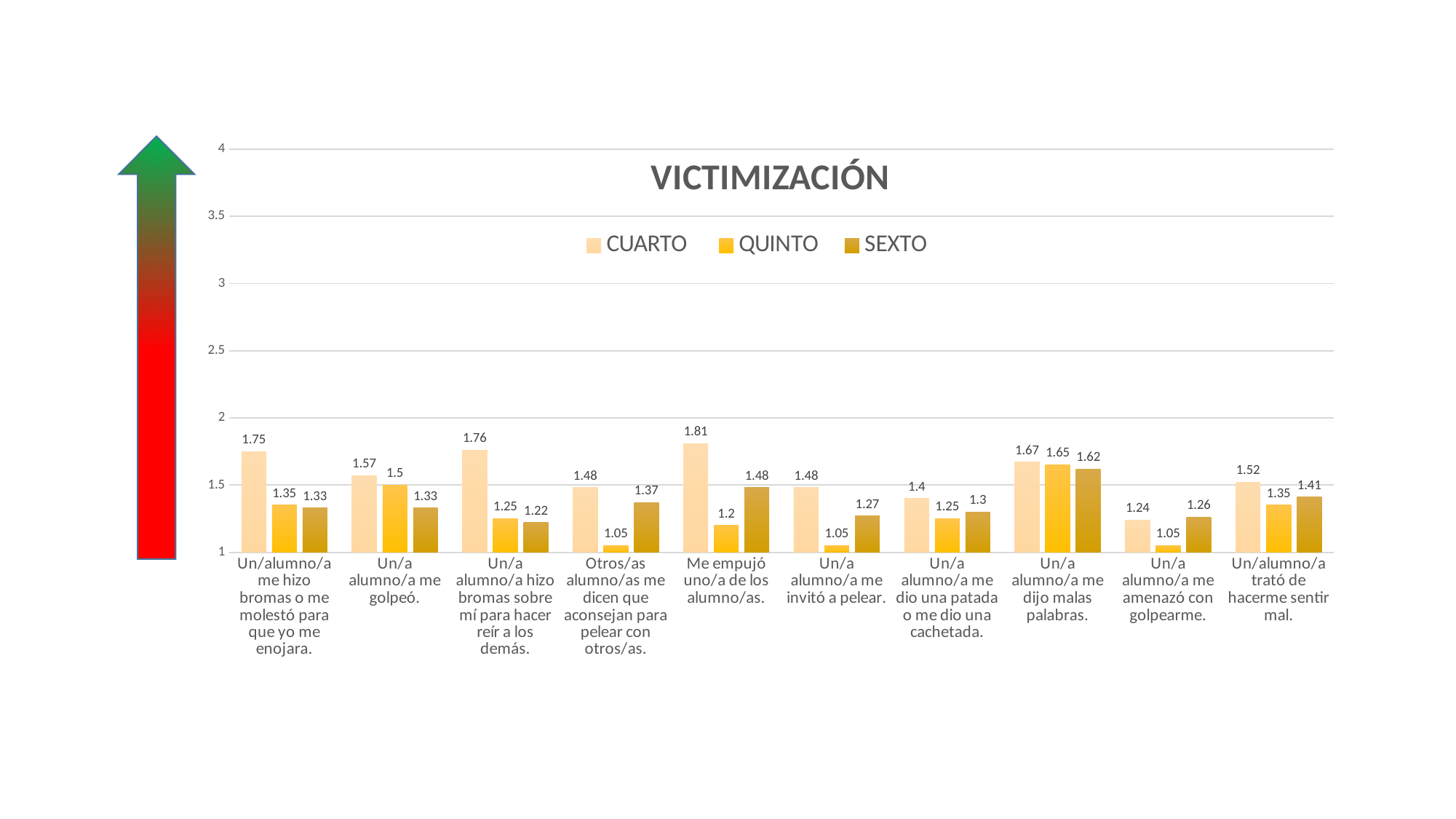
What is the title of the chart? VICTIMIZACIÓN What is the CUARTO value for "Me empujó uno/a de los alumno/as."? 1.81 Which category has the highest CUARTO value? Me empujó uno/a de los alumno/as. For "Un/a alumno/a me amenazó con golpearme.", which is larger: the CUARTO value or the SEXTO value? SEXTO What is the QUINTO value for "Un/a alumno/a me golpeó."? 1.5 How many categories are shown along the x axis? 10 Which category has the lowest CUARTO value? Un/a alumno/a me amenazó con golpearme. What is the difference between the CUARTO and QUINTO values for "Un/a alumno/a hizo bromas sobre mí para hacer reír a los demás."? 0.51 How many series does the legend list? 3 What kind of chart is shown on the slide? Bar chart Is the CUARTO value for "Un/alumno/a me hizo bromas o me molestó para que yo me enojara." greater or less than 2? less What is the SEXTO value for "Un/a alumno/a me dijo malas palabras."? 1.62